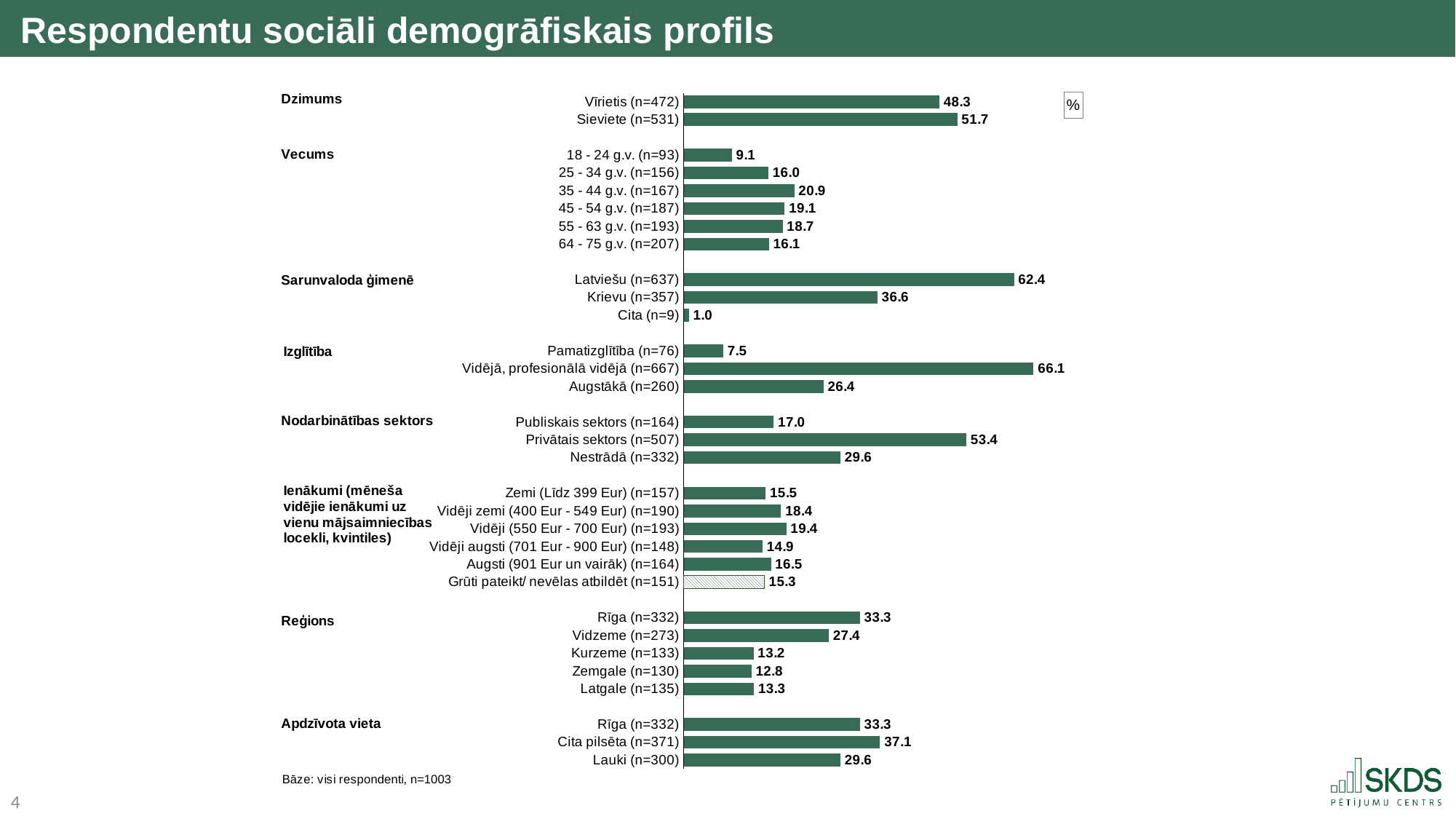
What is the value for Sieviete (n=531)? 51.7 Which is larger, Rīga (n=332) or Cita pilsēta (n=371) under Apdzīvota vieta? Cita pilsēta (n=371) Which is larger, Publiskais sektors (n=164) or Nestrādā (n=332)? Nestrādā (n=332) How many bars are shown under Reģions? 5 What kind of chart is shown on the slide? Bar chart What is the difference between Vīrietis (n=472) and Sieviete (n=531)? 3.4 What is the difference between Vidējā, profesionālā vidējā (n=667) and Augstākā (n=260)? 39.7 What is the value for Privātais sektors (n=507)? 53.4 What is the title of the slide? Respondentu sociāli demogrāfiskais profils Which age group (Vecums) has the highest value? 35 - 44 g.v. (n=167) What is the value for Latviešu (n=637)? 62.4 Which bar in the whole chart has the lowest value? Cita (n=9)